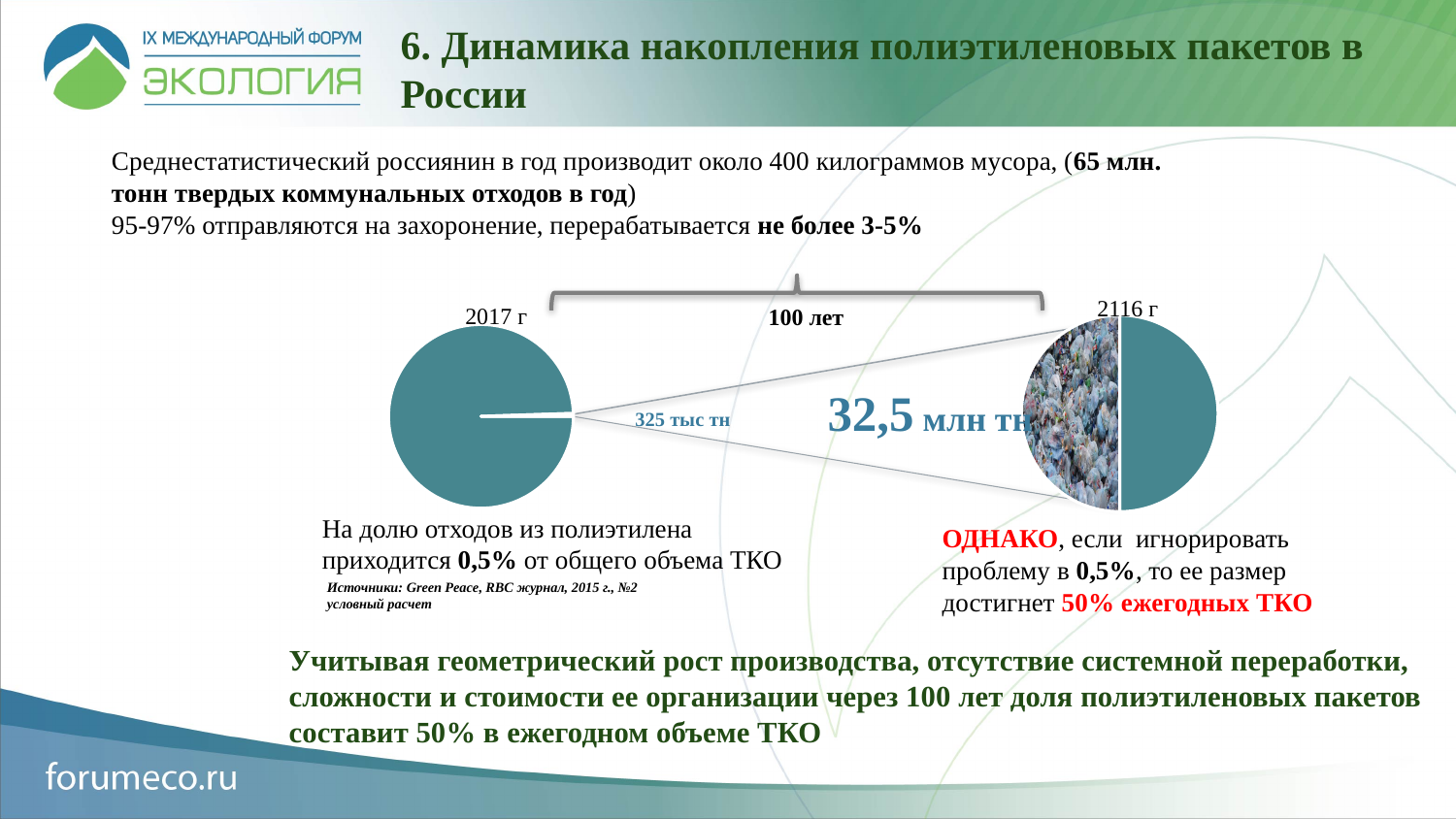
Which year is the right pie chart labelled with? 2116 г In the 2017 pie chart, what amount is given for the polyethylene waste slice? 325 тыс тн In the 2116 pie chart, what share of annual waste (ТКО) does polyethylene waste reach? 50% How many pie charts are shown on the slide? 2 Which pie chart shows the larger share for polyethylene waste, 2017 or 2116? 2116 How many years separate the two pie charts according to the bracket label? 100 лет In the 2116 pie chart, what amount is given for the polyethylene waste slice? 32,5 млн тн Which year is the left pie chart labelled with? 2017 г In the 2017 pie chart, what share of total waste (ТКО) does polyethylene waste account for? 0,5% In the 2116 pie chart, is the polyethylene slice greater or less than 25% of the pie? greater Does the share of polyethylene waste rise or fall from the 2017 pie chart to the 2116 pie chart? rise What kind of charts are shown on the slide? pie charts